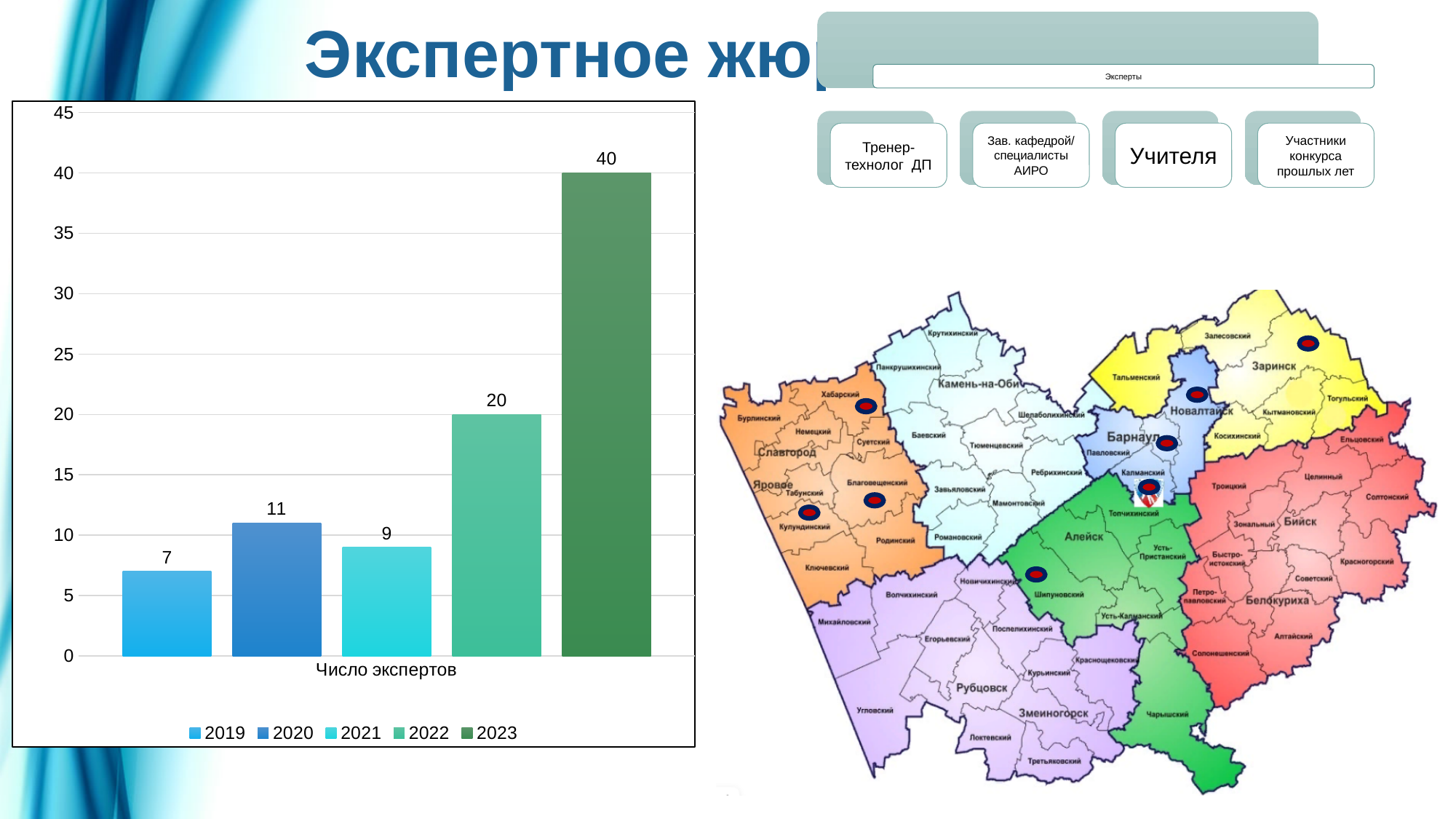
Which year has the lowest number of experts? 2019 What is the number of experts for 2019? 7 How many series does the legend list? 5 Is the value for 2022 greater or less than 15? greater What kind of chart is shown on the slide? bar chart What is the difference between the number of experts in 2023 and 2022? 20 What is the number of experts for 2023? 40 What is the label shown under the bars on the x axis? Число экспертов Which year has more experts, 2020 or 2021? 2020 Which year has the highest number of experts? 2023 What is the number of experts for 2021? 9 What is the difference between the number of experts in 2020 and 2021? 2